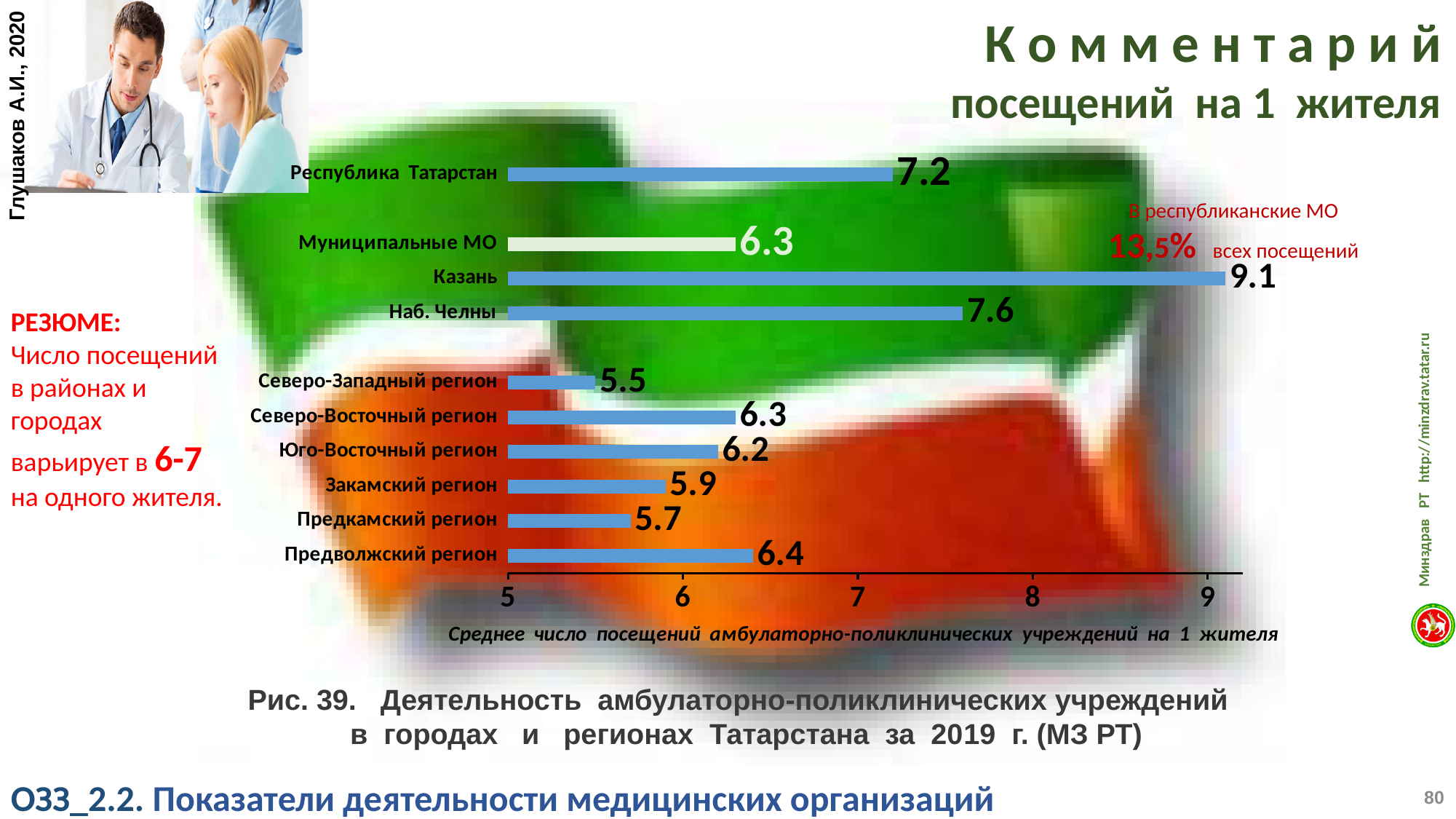
What is the difference between the values for Казань and Наб. Челны? 1.5 What is the value for Предволжский регион? 6.4 What is the x-axis title of the chart? Среднее число посещений амбулаторно-поликлинических учреждений на 1 жителя How many categories are shown in the chart? 10 What kind of chart is shown on the slide? bar chart What is the value for Казань? 9.1 What is the value for Республика Татарстан? 7.2 What is the value for Закамский регион? 5.9 Which category has the highest value? Казань Which category has the lowest value? Северо-Западный регион Which is larger, the value for Юго-Восточный регион or the value for Предкамский регион? Юго-Восточный регион Is the value for Наб. Челны greater or less than 7? greater